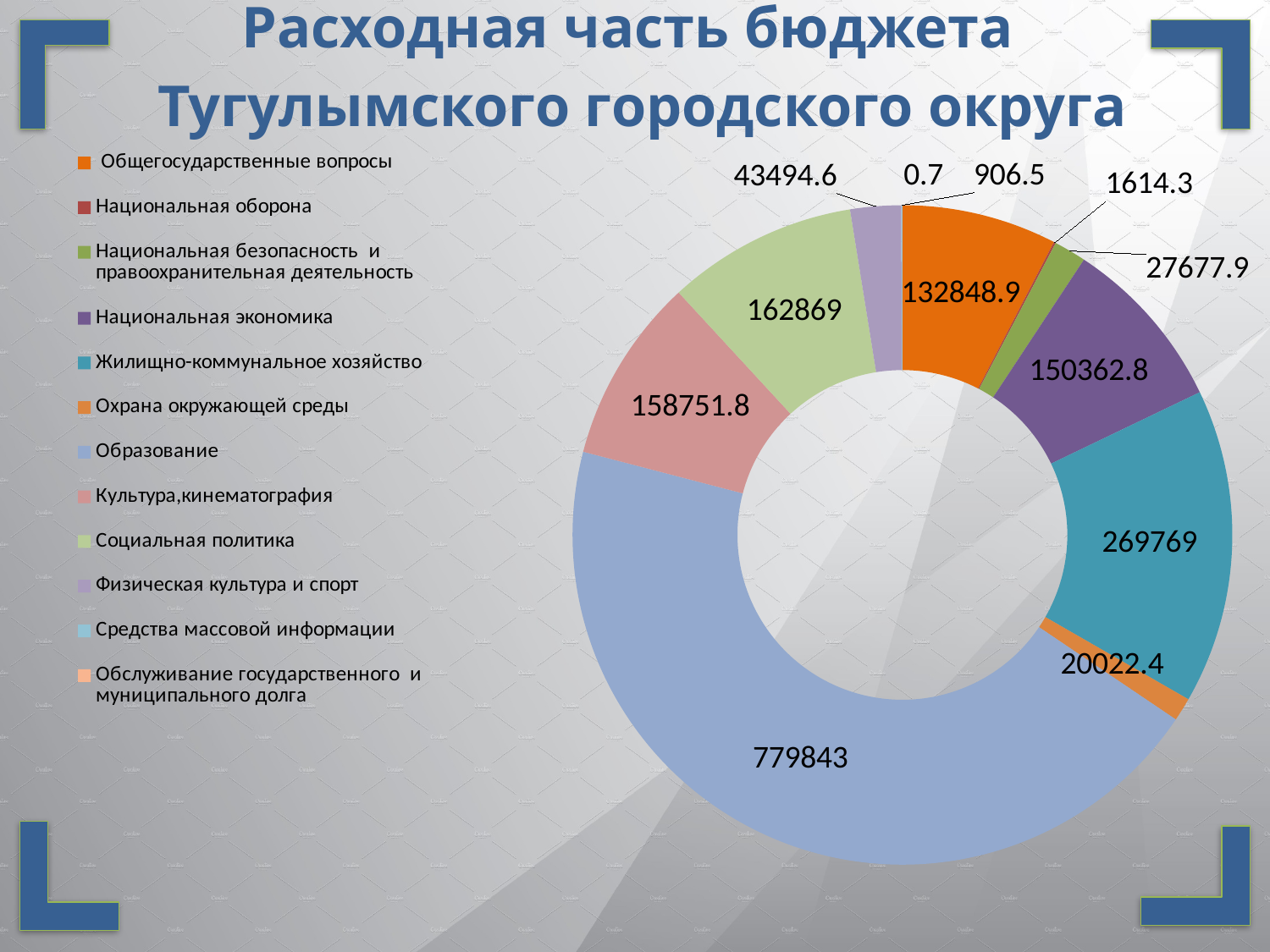
What type of chart is shown on the slide? pie chart (doughnut) What is the difference between the values for Жилищно-коммунальное хозяйство and Национальная экономика? 119406.2 What is the value shown for Охрана окружающей среды? 20022.4 What is the value shown for Общегосударственные вопросы? 132848.9 What is the value shown for Национальная экономика? 150362.8 What is the value shown for Жилищно-коммунальное хозяйство? 269769 Which is larger: Социальная политика or Культура,кинематография? Социальная политика Which category has the largest value in the chart? Образование Which category has the smallest value in the chart? Обслуживание государственного и муниципального долга What is the title of the chart on the slide? Расходная часть бюджета Тугулымского городского округа How many categories does the legend of the chart list? 12 What is the value shown for Образование? 779843